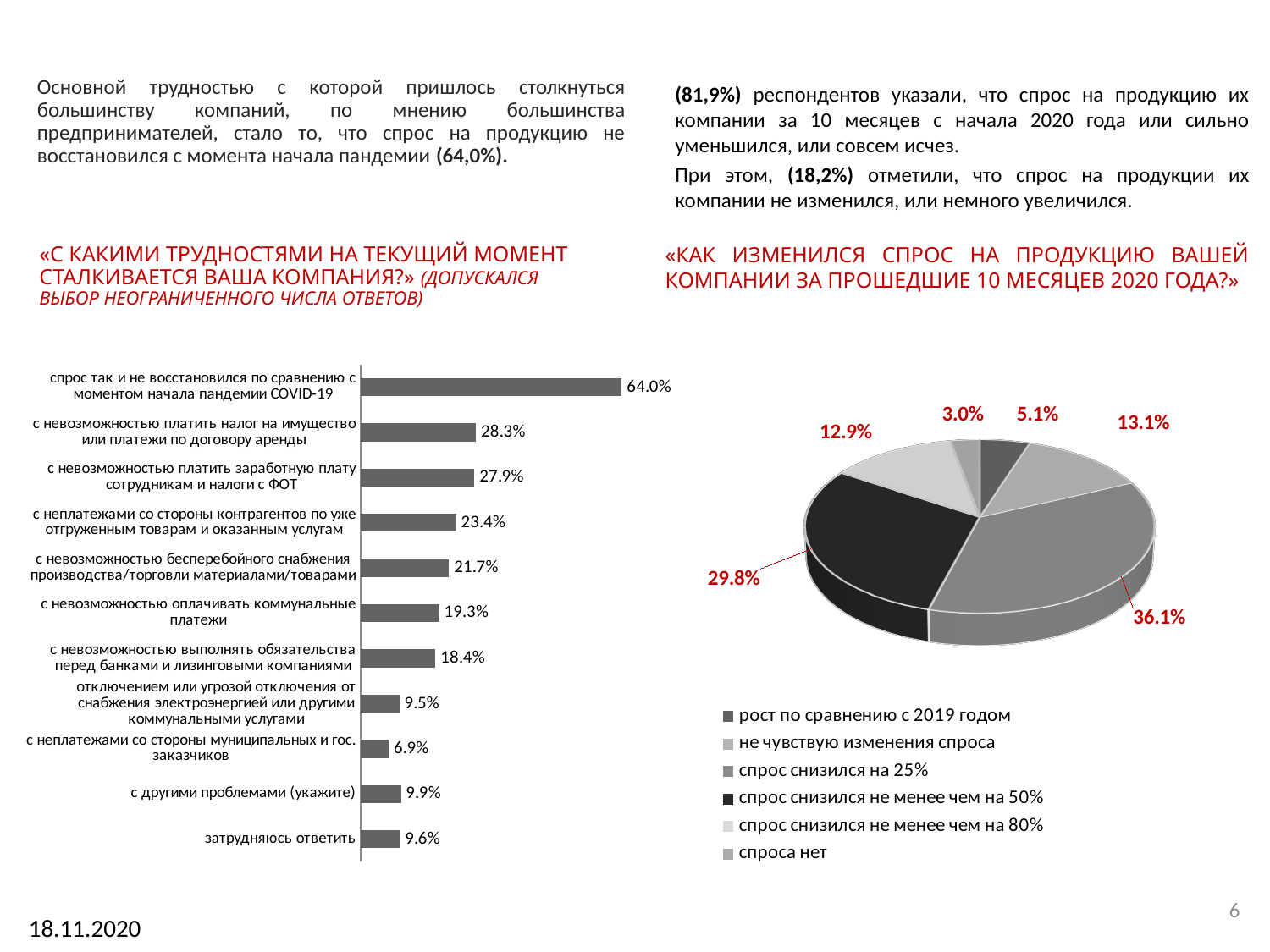
How many entries does the legend of the right pie chart list? 6 On the right pie chart, what is the largest slice's value? 36.1% What type of chart is the chart on the right of the slide? pie chart How many categories are shown on the left bar chart? 11 On the right pie chart, what is the smallest slice's value? 3.0% What type of chart is the chart on the left of the slide? bar chart On the left bar chart, what is the difference between «с невозможностью платить налог на имущество или платежи по договору аренды» and «с невозможностью платить заработную плату сотрудникам и налоги с ФОТ»? 0.4% On the left bar chart, what is the value for «спрос так и не восстановился по сравнению с моментом начала пандемии COVID-19»? 64.0% On the left bar chart, which category has the lowest value? с неплатежами со стороны муниципальных и гос. заказчиков On the left bar chart, which is larger: «с другими проблемами (укажите)» or «затрудняюсь ответить»? с другими проблемами (укажите) On the right pie chart, what share is labelled for «спрос снизился не менее чем на 50%»? 29.8% On the left bar chart, what is the value for «с невозможностью оплачивать коммунальные платежи»? 19.3%